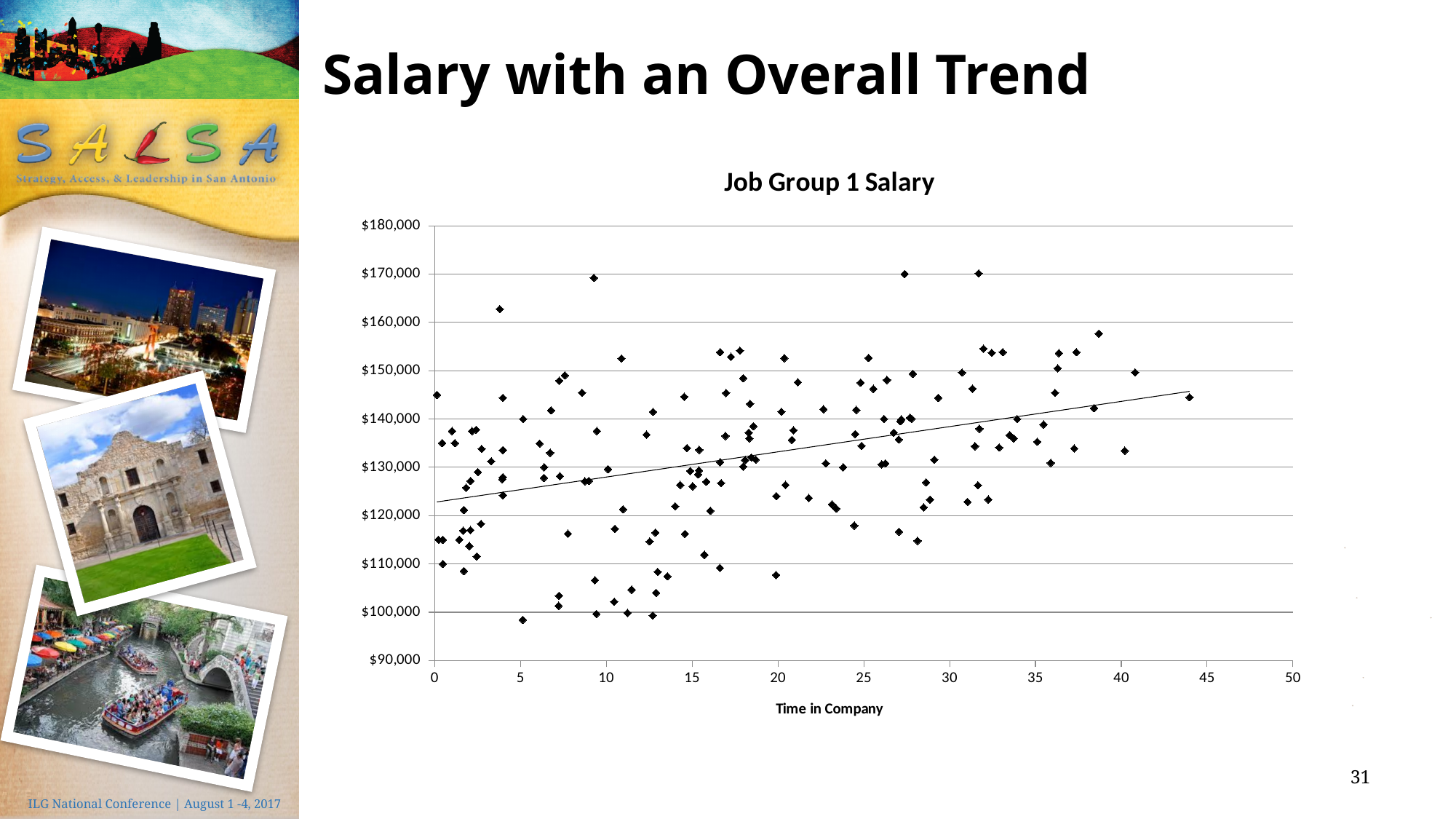
Is the highest plotted salary greater or less than $160,000? greater Is the lowest plotted salary greater or less than $100,000? less What is the label of the x axis? Time in Company What is the title of the chart? Job Group 1 Salary What kind of chart is shown on the slide? Scatter chart Does the trend line rise or fall as Time in Company increases? Rises Is the trend line's value at Time in Company 40 greater or less than its value at Time in Company 0? greater Is the trend line's value at Time in Company 0 greater or less than $130,000? less